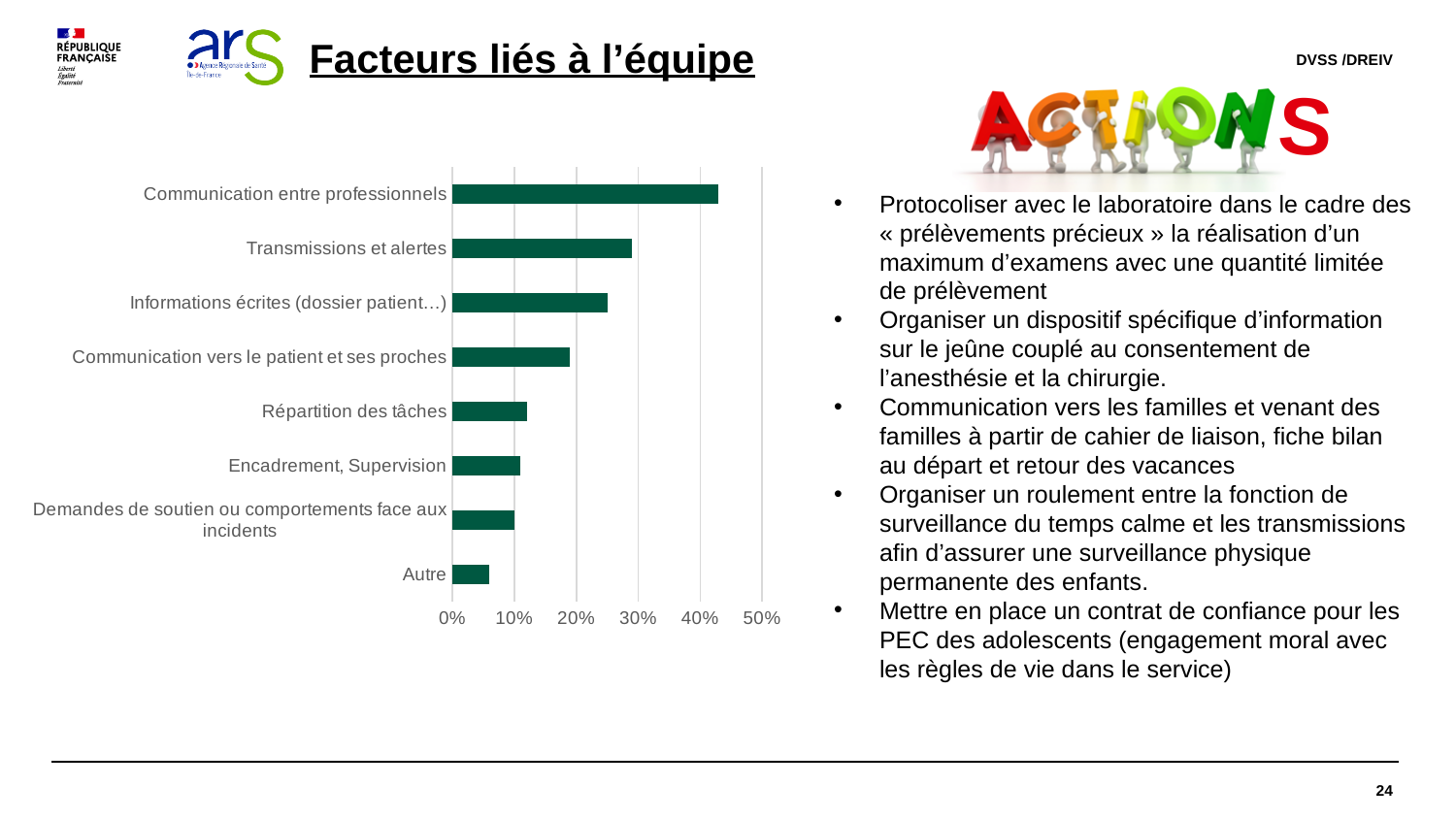
Which is larger: the value for Transmissions et alertes or the value for Répartition des tâches? Transmissions et alertes What is the title of the slide containing the chart? Facteurs liés à l'équipe Is the value for Communication entre professionnels greater or less than 50%? less Is the value for Informations écrites (dossier patient…) greater or less than 20%? greater How many categories are shown in the bar chart? 8 Is the value for Communication entre professionnels greater or less than 40%? greater Which category has the lowest value in the chart? Autre What kind of chart is shown on the slide? Bar chart Which category has the highest value in the chart? Communication entre professionnels